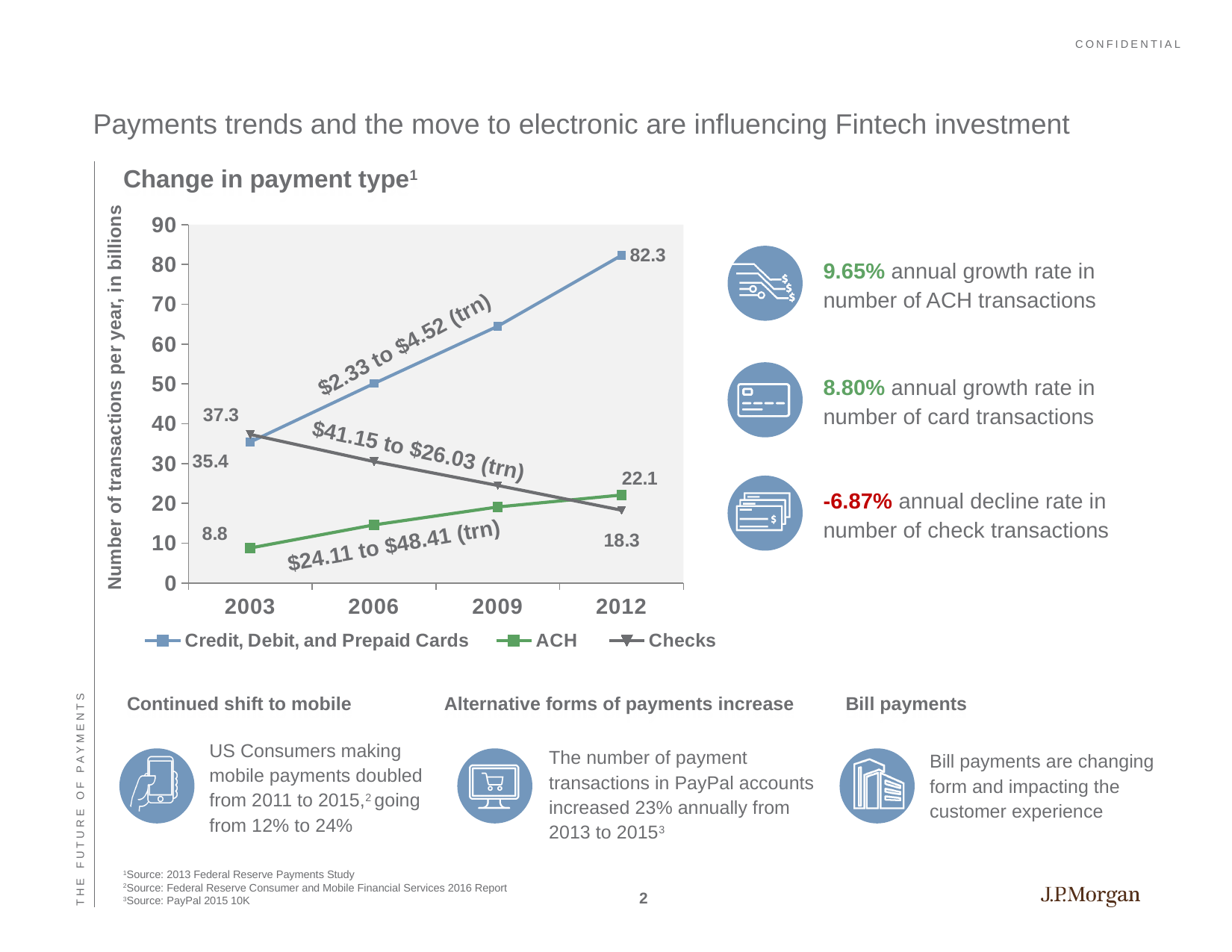
Is the value for Checks in 2009 greater or less than 30? less What is the value for Checks in 2003? 37.3 In 2003, which series had the larger value: Checks or Credit, Debit, and Prepaid Cards? Checks What is the difference between the ACH values in 2012 and 2003? 13.3 By how much did the value for Credit, Debit, and Prepaid Cards increase from 2003 to 2012? 46.9 What kind of chart is shown on the slide? line chart What is the value for Checks in 2012? 18.3 Do the values for Checks rise or fall from 2003 to 2012? fall How many series does the legend list? 3 What is the value for Credit, Debit, and Prepaid Cards in 2012? 82.3 What is the value for ACH in 2003? 8.8 How many years are shown on the x axis? 4